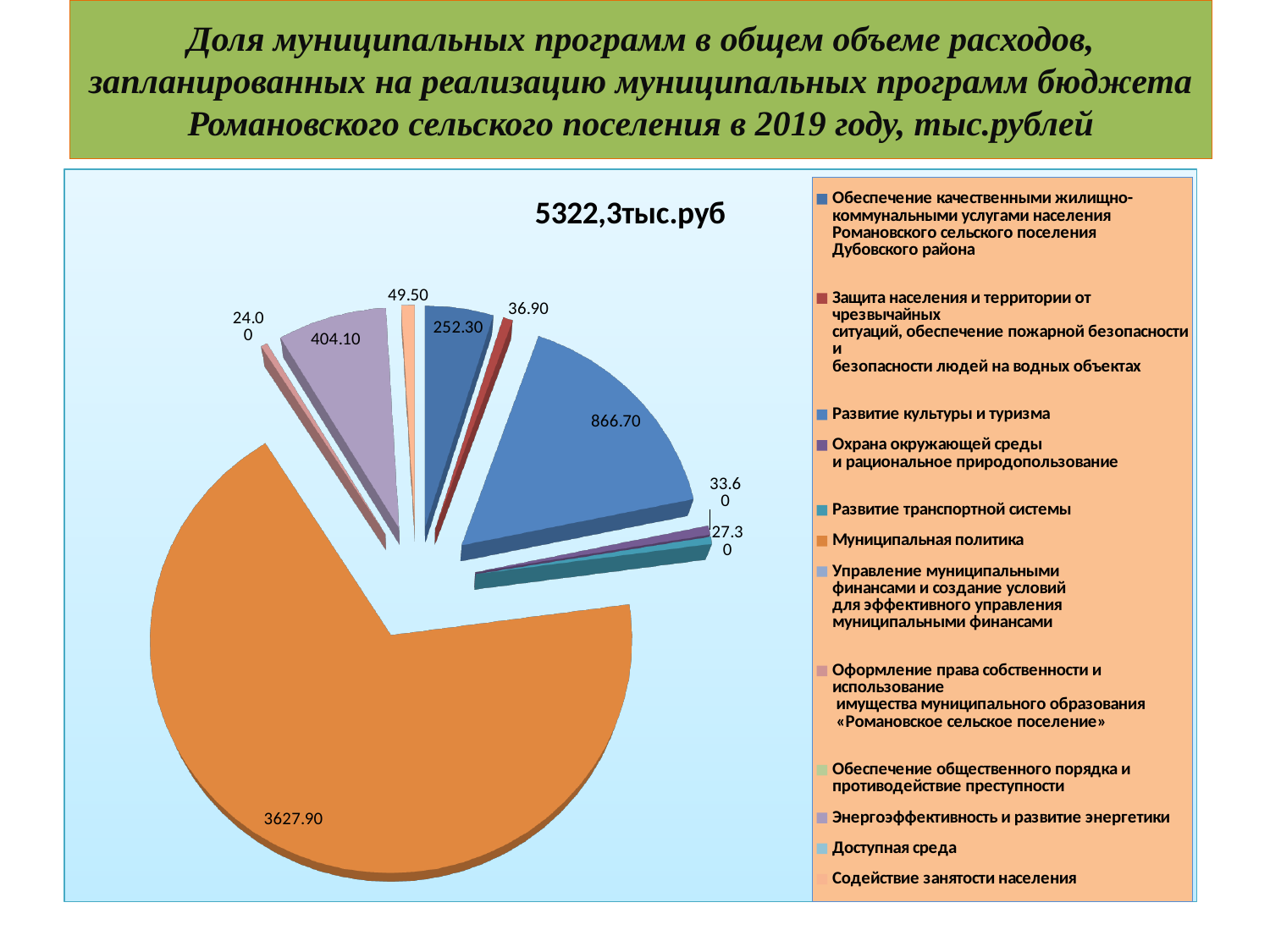
What kind of chart is shown on the slide? pie chart What value is shown for the slice "Охрана окружающей среды и рациональное природопользование"? 33.60 What value is shown for the slice "Защита населения и территории от чрезвычайных ситуаций, обеспечение пожарной безопасности и безопасности людей на водных объектах"? 36.90 Which is larger: the value for "Управление муниципальными финансами и создание условий для эффективного управления муниципальными финансами" or for "Обеспечение качественными жилищно-коммунальными услугами населения Романовского сельского поселения Дубовского района"? Обеспечение качественными жилищно-коммунальными услугами населения Романовского сельского поселения Дубовского района (252.30) Which labelled slice has the smallest value? Оформление права собственности и использование имущества муниципального образования «Романовское сельское поселение» (24.00) Which program has the largest slice of the pie? Муниципальная политика How many entries does the chart legend list? 12 What value is shown for the slice "Развитие транспортной системы"? 27.30 What total amount is shown in the chart title above the pie? 5322,3тыс.руб What value is shown for the slice "Муниципальная политика"? 3627.90 What value is shown for the slice "Развитие культуры и туризма"? 866.70 What is the difference between the values for "Развитие культуры и туризма" and "Обеспечение качественными жилищно-коммунальными услугами населения Романовского сельского поселения Дубовского района"? 614.40